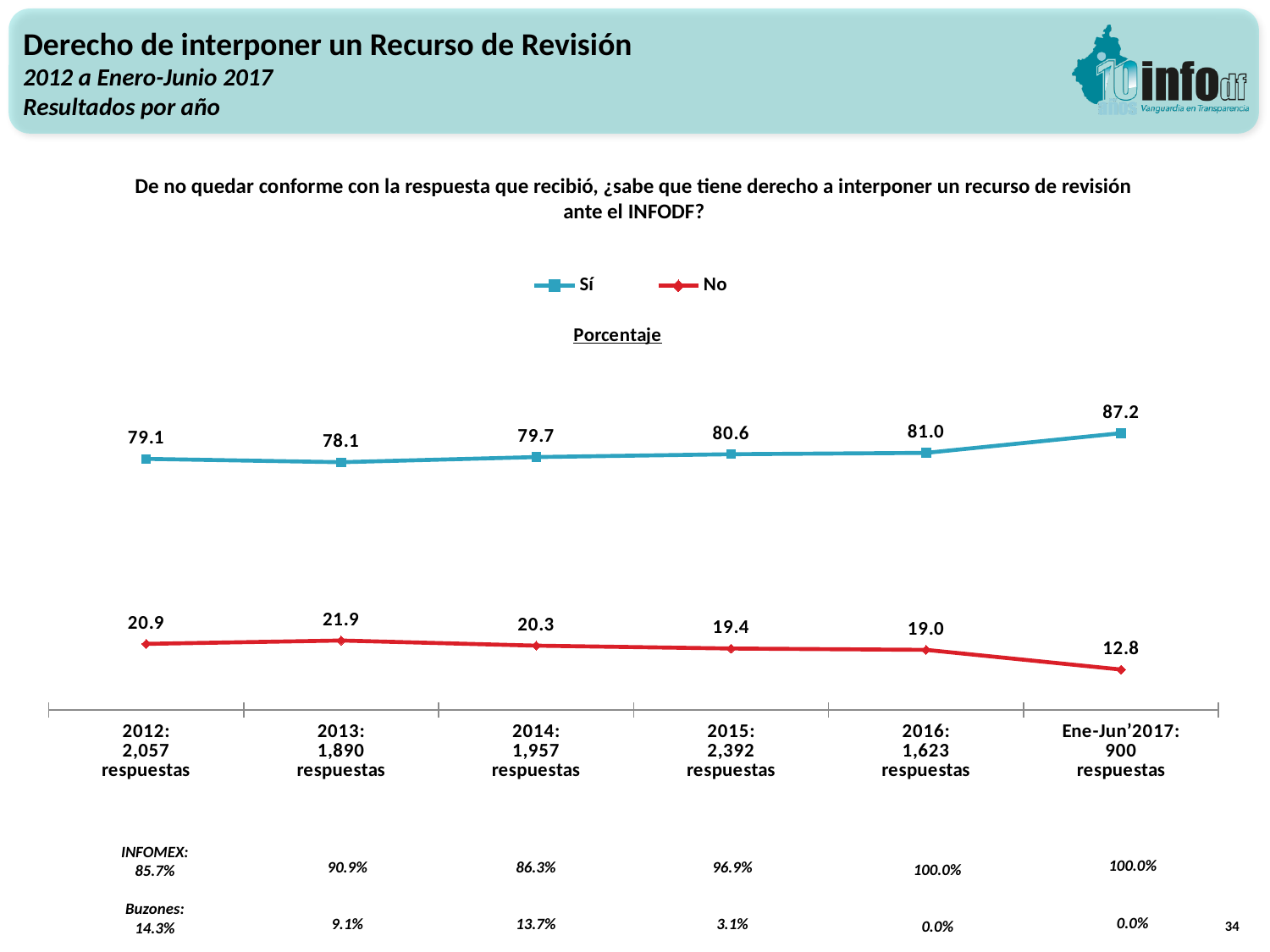
Which is larger, the No value for 2014 or the No value for 2015? 2014 In which year is the No series highest? 2013 What is the value of the Sí series for 2012? 79.1 In which year is the Sí series highest? Ene-Jun'2017 In which year is the Sí series lowest? 2013 Does the No series rise or fall from 2013 to Ene-Jun'2017? Fall How many time periods are plotted on the x axis? 6 What kind of chart is shown on the slide? Line chart What is the difference between the Sí values for Ene-Jun'2017 and 2016? 6.2 How many series does the legend list? 2 What is the value of the Sí series for 2015? 80.6 What is the value of the No series for Ene-Jun'2017? 12.8